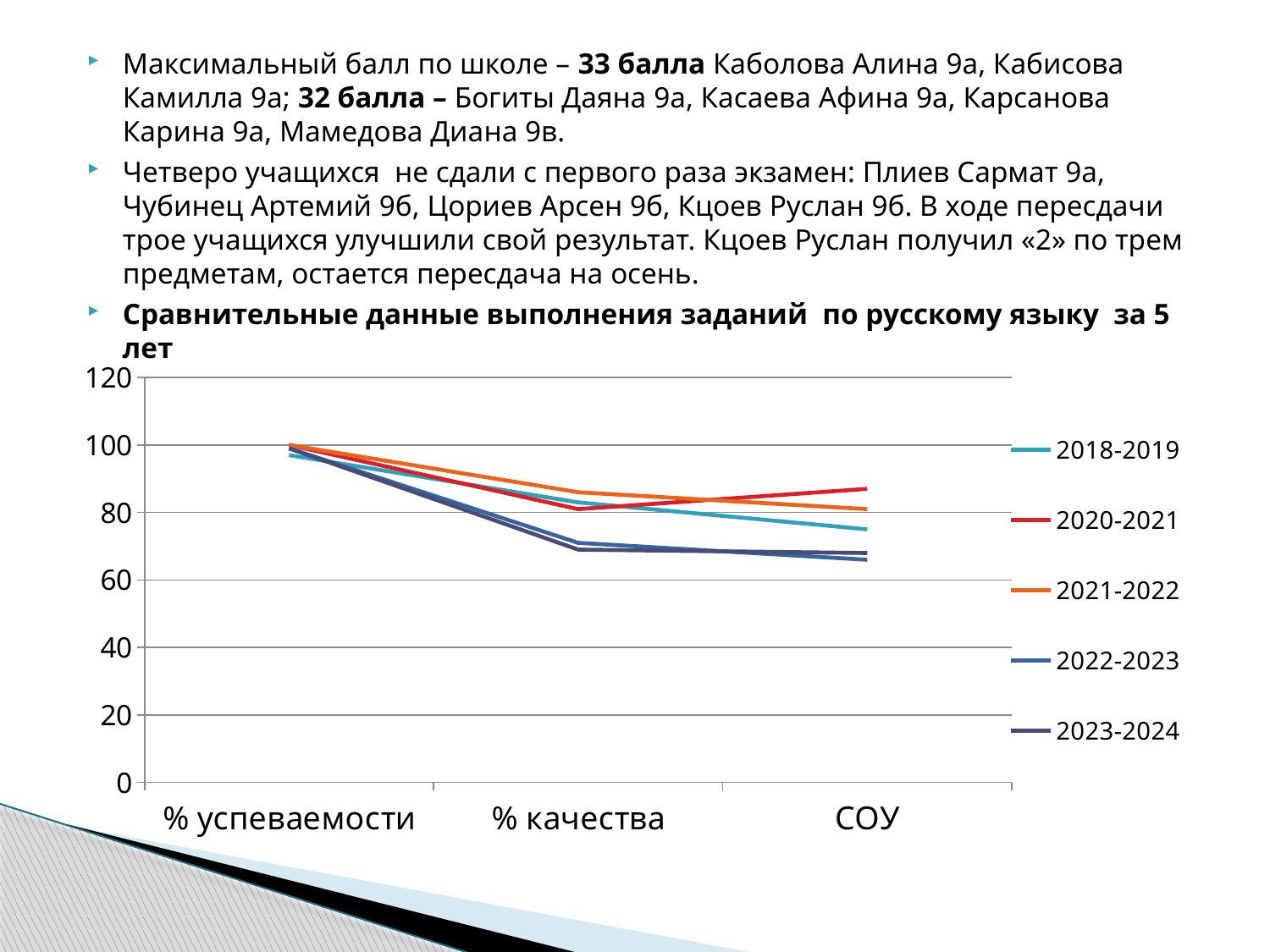
Which series is listed first in the chart legend? 2018-2019 Do the values for the 2018-2019 series rise or fall from % успеваемости to СОУ? fall Is the value for 2023-2024 at % качества greater or less than 80? less At СОУ, which is larger: the value for 2018-2019 or the value for 2022-2023? 2018-2019 How many categories are shown along the x axis of the chart? 3 Is the value for 2020-2021 at СОУ greater or less than 80? greater What kind of chart is shown on the slide? line chart Is the value for 2022-2023 at СОУ greater or less than 80? less How many series does the chart legend list? 5 Which series has the highest value at СОУ? 2020-2021